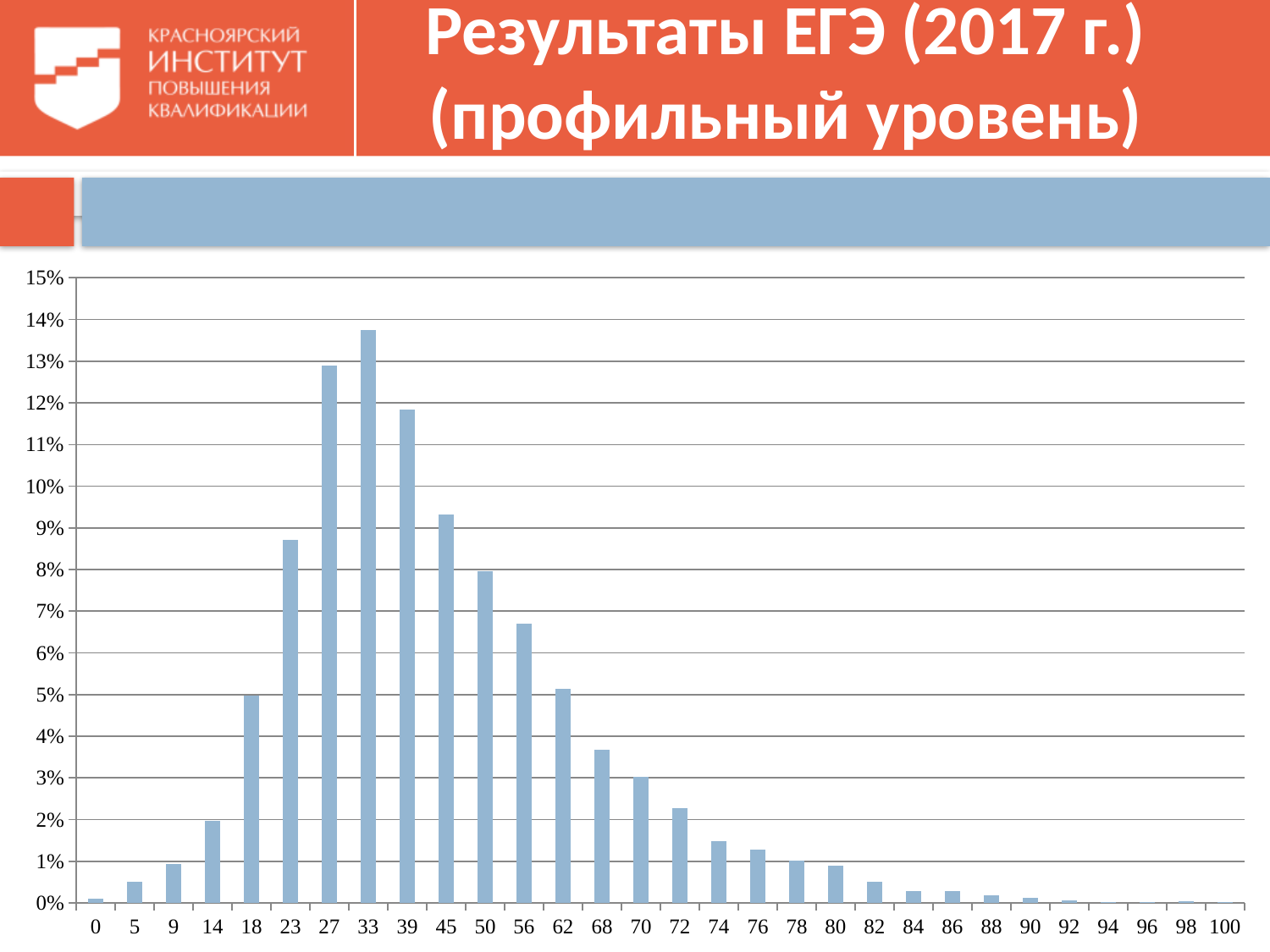
Which score category has the highest bar? 33 Do the values rise or fall along the x axis from 33 to 100? fall Which is larger, the value for 27 or the value for 39? 27 Is the value for 45 greater or less than 10%? less Is the value for 33 greater or less than 13%? greater How many score categories are shown on the x axis? 30 What kind of chart is shown on the slide? bar chart Is the value for 68 greater or less than 4%? less What is the title of the slide containing the chart? Результаты ЕГЭ (2017 г.) (профильный уровень) Which is larger, the value for 23 or the value for 45? 45